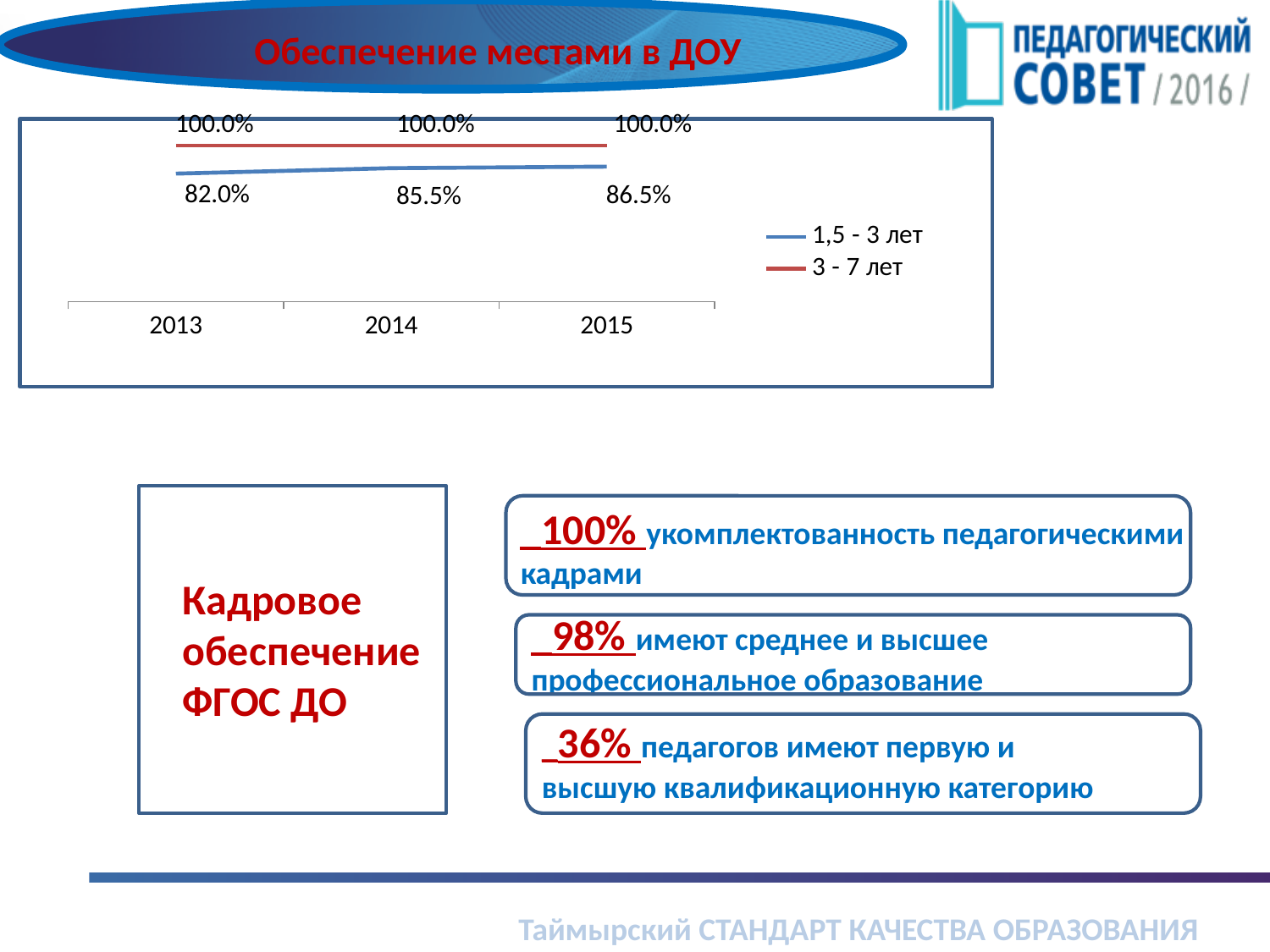
Does the value for the series "1,5 - 3 лет" rise or fall from 2013 to 2015? rise What is the value for the series "1,5 - 3 лет" in 2014? 85.5% How many years are shown on the x axis of the chart? 3 How many series does the chart legend list? 2 What is the value for the series "1,5 - 3 лет" in 2015? 86.5% In which year is the value for the series "1,5 - 3 лет" the highest? 2015 In which year is the value for the series "1,5 - 3 лет" the lowest? 2013 What is the value for the series "3 - 7 лет" in 2015? 100.0% Which series is shown with a red line in the chart? 3 - 7 лет What is the value for the series "1,5 - 3 лет" in 2013? 82.0% What type of chart is shown on the slide? line chart What is the difference between the 2015 and 2013 values for the series "1,5 - 3 лет"? 4.5%